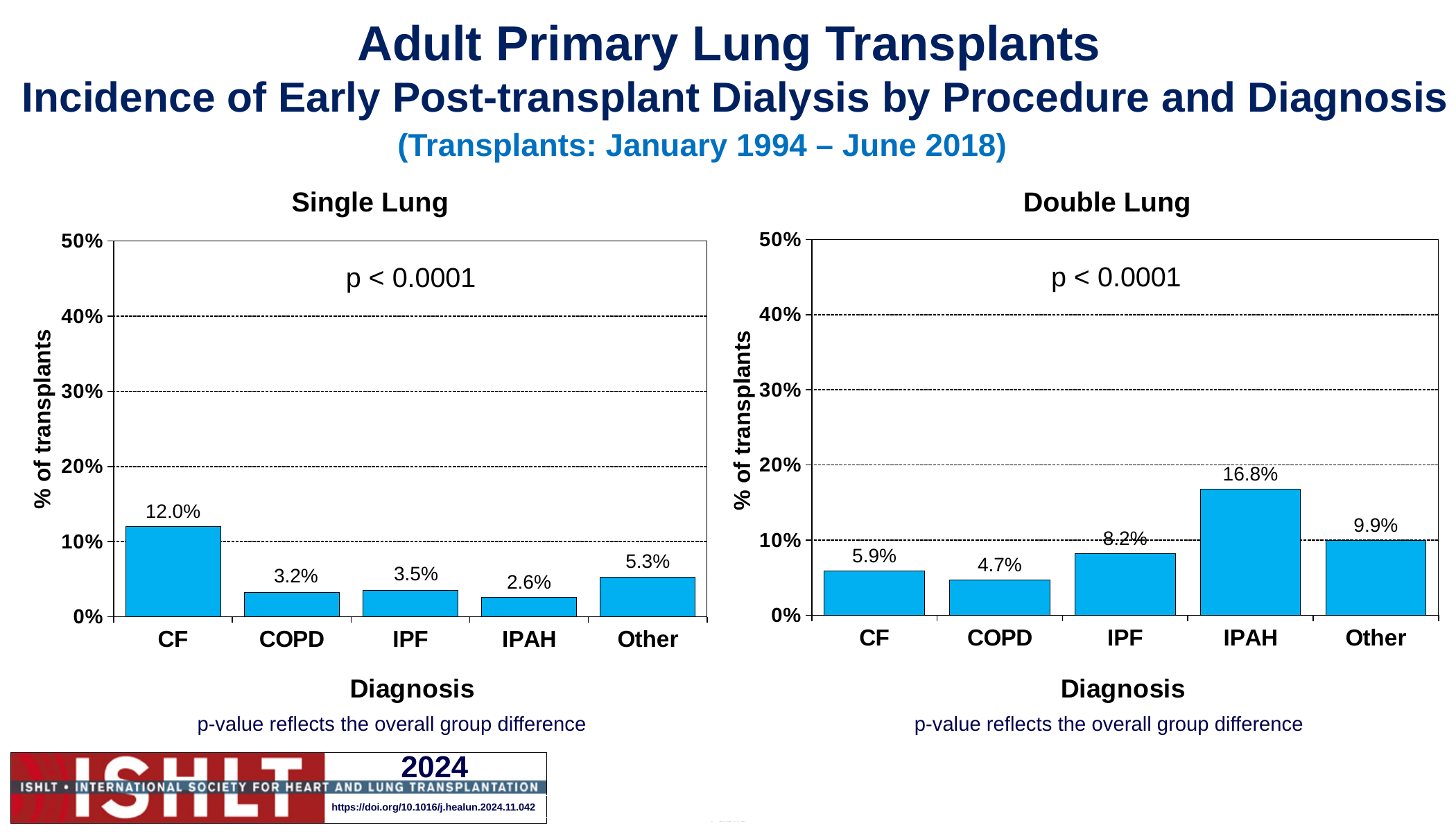
What kind of chart is the Double Lung chart? Bar chart In the Single Lung chart, what is the value for CF? 12.0% In the Single Lung chart, what is the value for IPAH? 2.6% In the Single Lung chart, what is the difference between the CF and Other values? 6.7% In the Single Lung chart, which diagnosis has the highest value? CF In the Double Lung chart, what is the value for Other? 9.9% In the Double Lung chart, what is the value for IPAH? 16.8% In the Double Lung chart, which is larger, the value for IPF or the value for COPD? IPF In the Double Lung chart, what is the difference between the IPAH and CF values? 10.9% How many diagnosis categories are shown in the Single Lung chart? 5 In the Single Lung chart, which diagnosis has the lowest value? IPAH In the Double Lung chart, which diagnosis has the lowest value? COPD